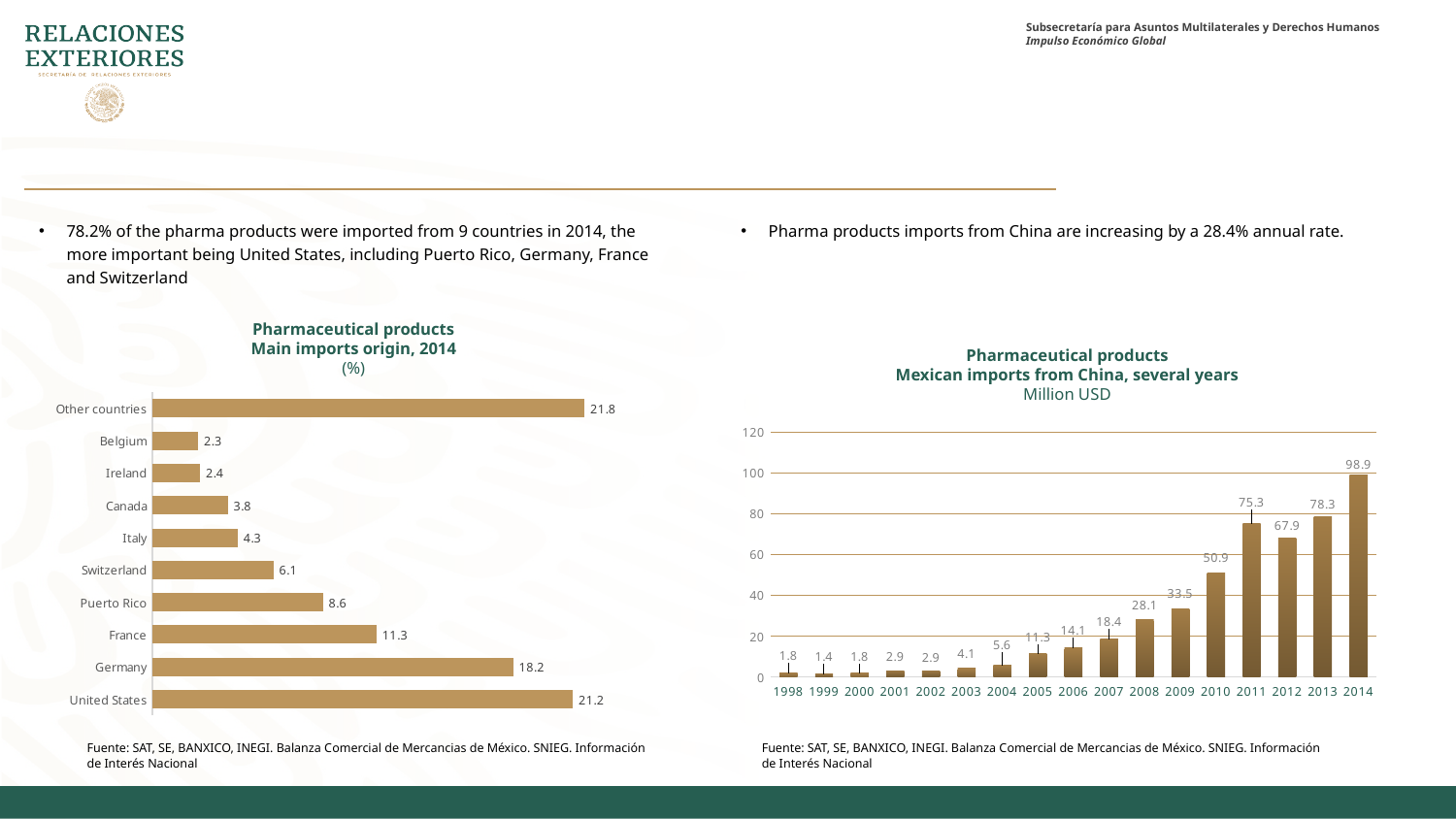
In the 'Pharmaceutical products Mexican imports from China, several years' chart, which year has the highest value? 2014 In the 'Pharmaceutical products Mexican imports from China, several years' chart, what is the value for 2010? 50.9 In the 'Pharmaceutical products Main imports origin, 2014' chart, what is the value for Switzerland? 6.1 How many categories are shown in the 'Pharmaceutical products Main imports origin, 2014' chart? 10 In the 'Pharmaceutical products Main imports origin, 2014' chart, what is the difference between the values for United States and France? 9.9 What kind of chart is the 'Pharmaceutical products Main imports origin, 2014' chart? Bar chart What unit is stated in the subtitle of the 'Pharmaceutical products Mexican imports from China, several years' chart? Million USD In the 'Pharmaceutical products Main imports origin, 2014' chart, what is the value for Germany? 18.2 In the 'Pharmaceutical products Mexican imports from China, several years' chart, which year has the lowest value? 1999 In the 'Pharmaceutical products Main imports origin, 2014' chart, which has a larger value, Canada or Italy? Italy In the 'Pharmaceutical products Mexican imports from China, several years' chart, which is larger, the value for 2011 or 2012? 2011 In the 'Pharmaceutical products Mexican imports from China, several years' chart, what is the difference between the values for 2014 and 2013? 20.6